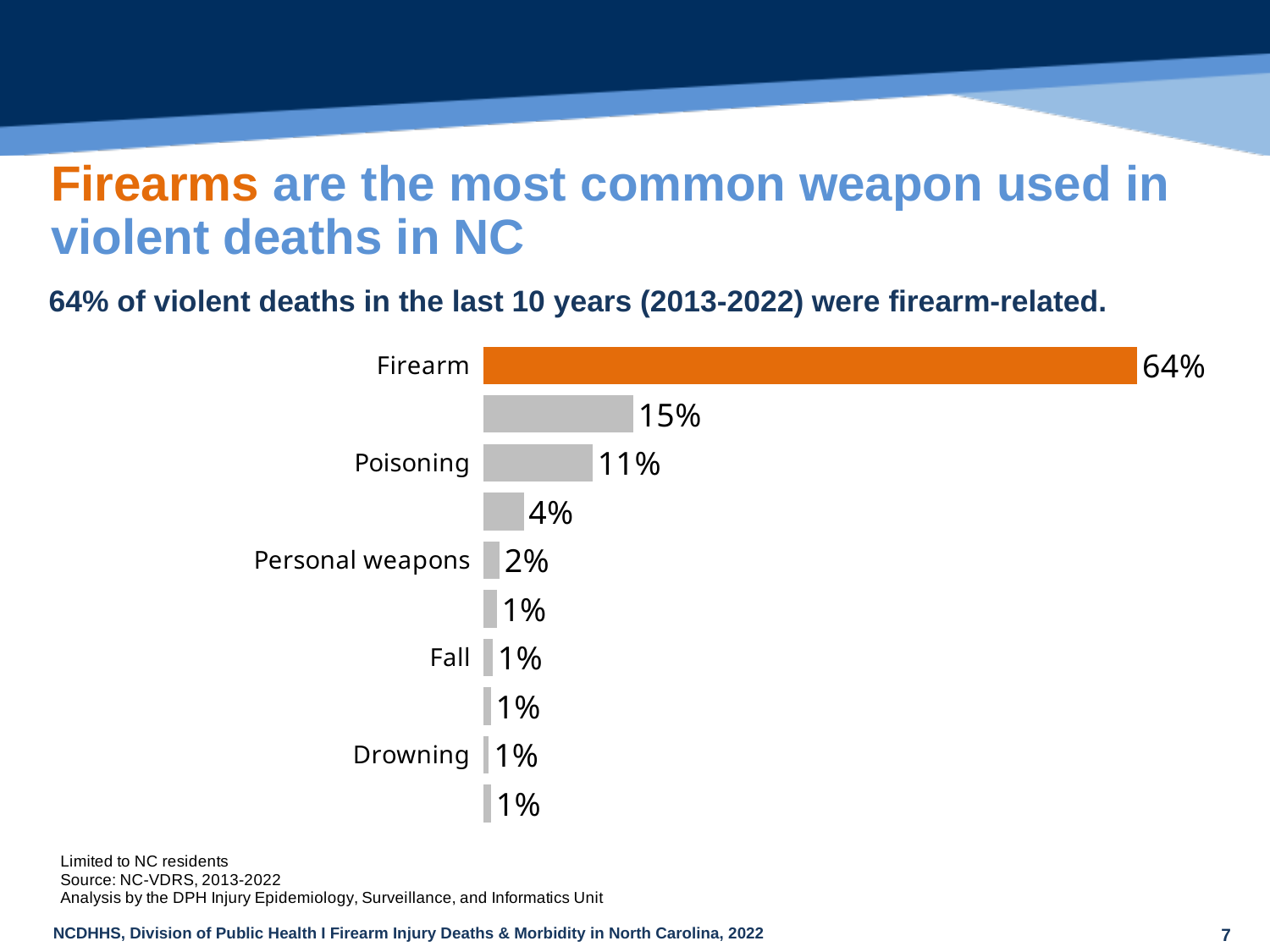
Which is larger, the value for Poisoning or the value for Personal weapons? Poisoning Which category has the highest value in the chart? Firearm What is the difference between the Poisoning value and the Personal weapons value? 9% What percentage of violent deaths does the chart show for Firearm? 64% How many bars are plotted in the chart? 10 What kind of chart is shown on the slide? Bar chart What value is shown for Personal weapons? 2% What value is shown for Drowning? 1% What value is shown for Poisoning? 11% What value is shown for Fall? 1% What is the difference between the Firearm value and the Poisoning value? 53% What colour is the Firearm bar? Orange